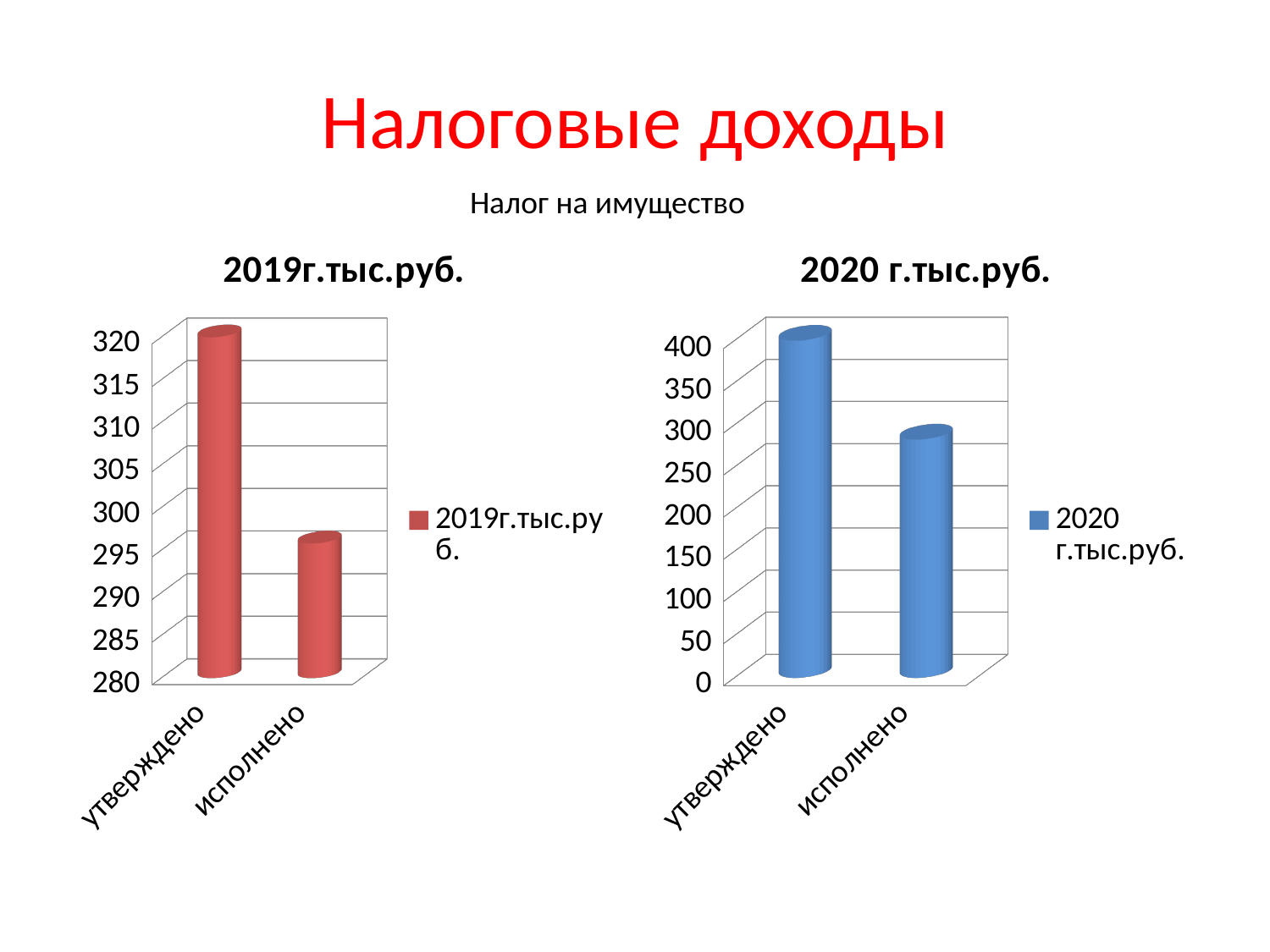
In the left chart "2019г.тыс.руб.", is the value for утверждено greater or less than 310? greater In the left chart "2019г.тыс.руб.", is the value for исполнено greater or less than 300? less How many series does the legend of the right chart "2020 г.тыс.руб." list? 1 In the right chart "2020 г.тыс.руб.", which is larger, утверждено or исполнено? утверждено In the right chart "2020 г.тыс.руб.", is the value for утверждено greater or less than 350? greater What type of chart is the left chart titled "2019г.тыс.руб."? bar chart In the right chart "2020 г.тыс.руб.", which category has the highest value? утверждено How many categories are shown in the left chart "2019г.тыс.руб."? 2 In the left chart "2019г.тыс.руб.", which category has the lowest value? исполнено What colour are the bars in the right chart "2020 г.тыс.руб."? blue In the left chart "2019г.тыс.руб.", which category has the highest value? утверждено